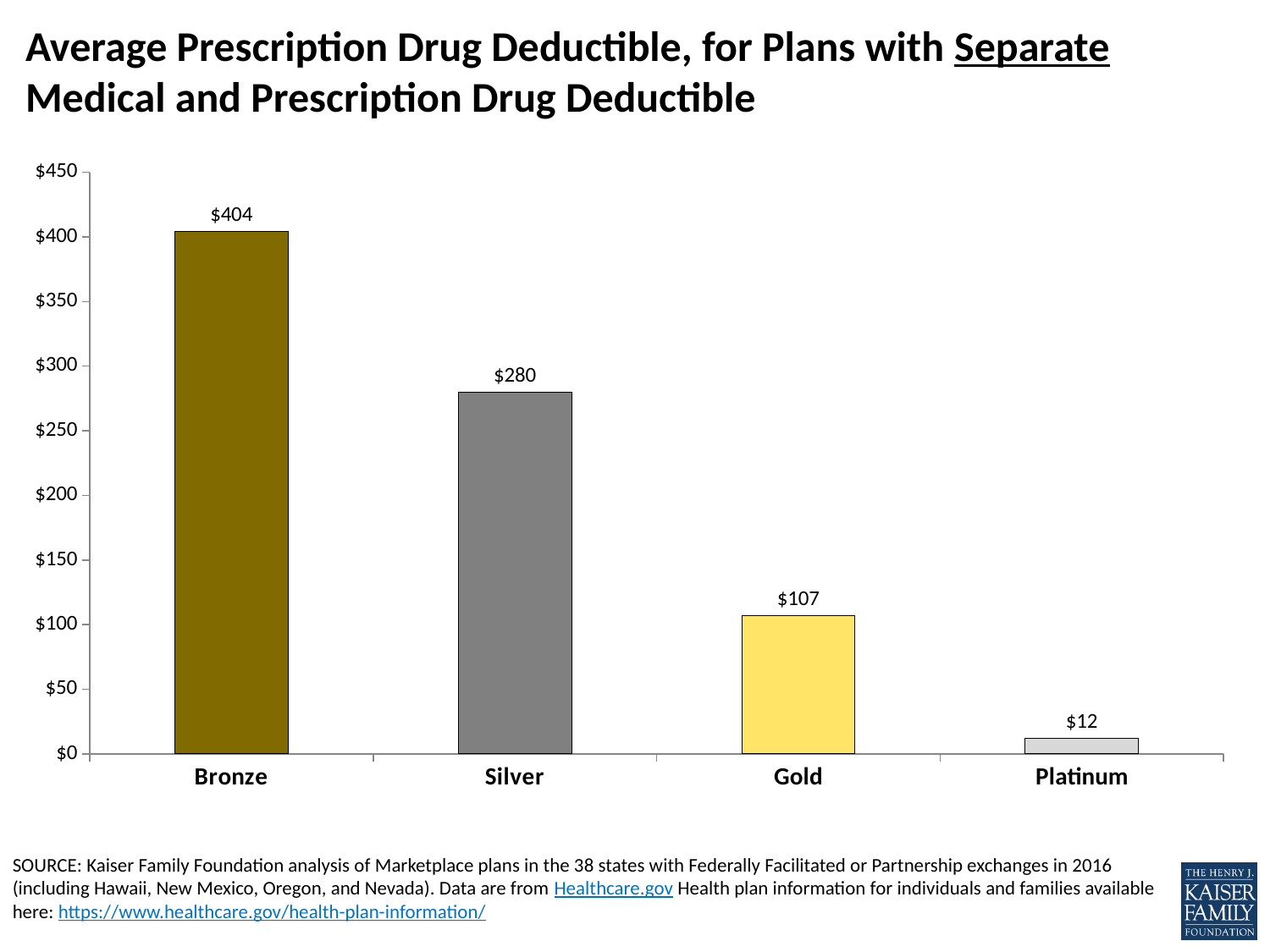
What is the average prescription drug deductible for Silver plans? $280 What is the average prescription drug deductible for Bronze plans? $404 Which has a larger average prescription drug deductible, Silver or Gold? Silver Do the values rise or fall moving from Bronze to Platinum along the x axis? Fall What is the difference between the Gold and Platinum average prescription drug deductibles? $95 What is the difference between the Bronze and Silver average prescription drug deductibles? $124 How many plan types are shown in the chart? 4 What is the average prescription drug deductible for Gold plans? $107 What kind of chart is shown on the slide? Bar chart Which plan type has the highest average prescription drug deductible? Bronze What is the average prescription drug deductible for Platinum plans? $12 Which plan type has the lowest average prescription drug deductible? Platinum